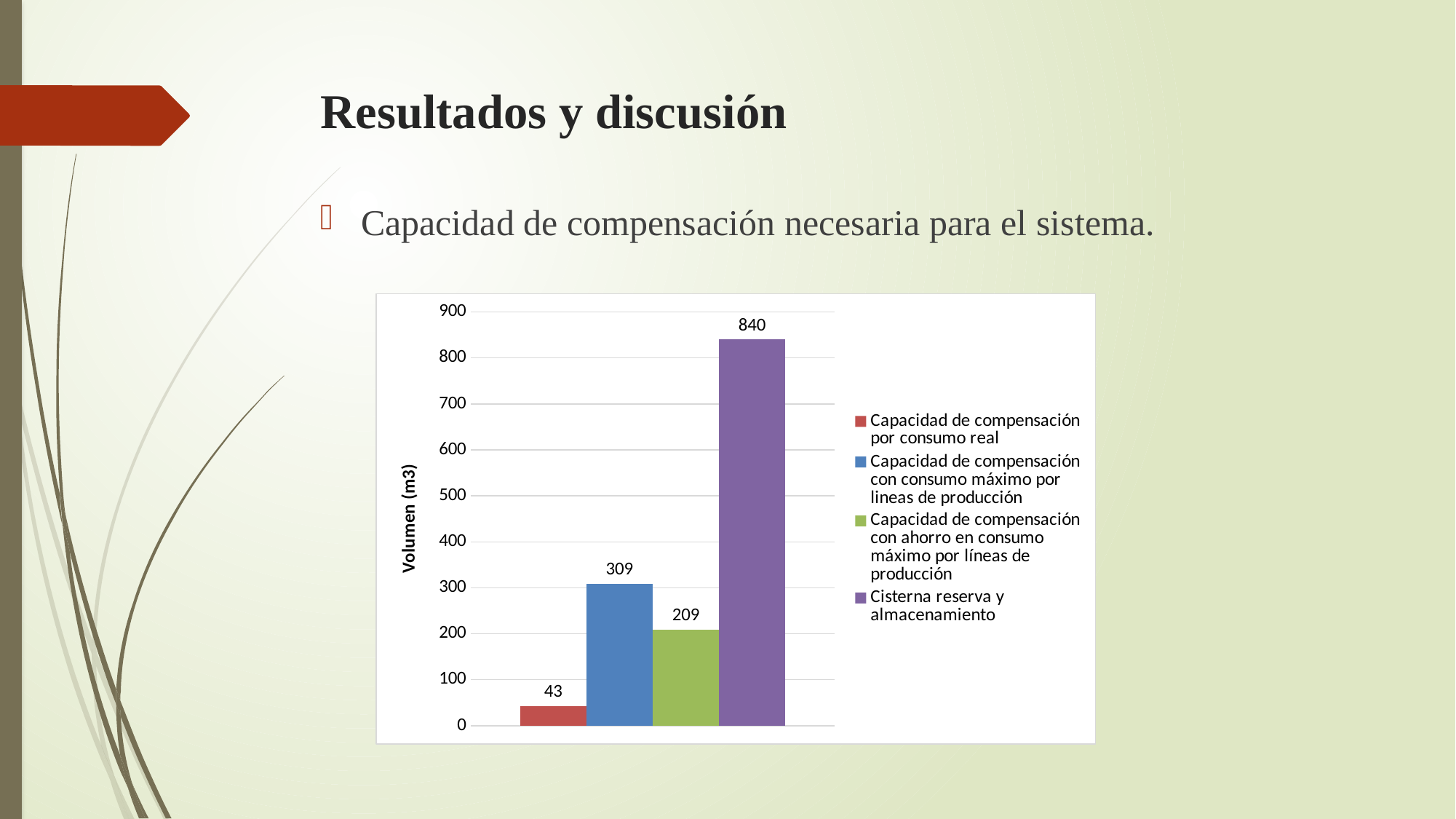
How many series does the legend list? 4 Which series has the lowest value? Capacidad de compensación por consumo real What is the difference between 'Cisterna reserva y almacenamiento' and 'Capacidad de compensación con consumo máximo por lineas de producción'? 531 What is the value for 'Capacidad de compensación con ahorro en consumo máximo por líneas de producción'? 209 What kind of chart is shown on the slide? Bar chart What is the difference between 'Capacidad de compensación con consumo máximo por lineas de producción' and 'Capacidad de compensación con ahorro en consumo máximo por líneas de producción'? 100 What is the label of the vertical axis? Volumen (m3) What is the value for 'Capacidad de compensación por consumo real'? 43 Which series has the highest value? Cisterna reserva y almacenamiento What is the value for 'Cisterna reserva y almacenamiento'? 840 Which is larger: 'Capacidad de compensación con ahorro en consumo máximo por líneas de producción' or 'Capacidad de compensación por consumo real'? Capacidad de compensación con ahorro en consumo máximo por líneas de producción What is the value for 'Capacidad de compensación con consumo máximo por lineas de producción'? 309